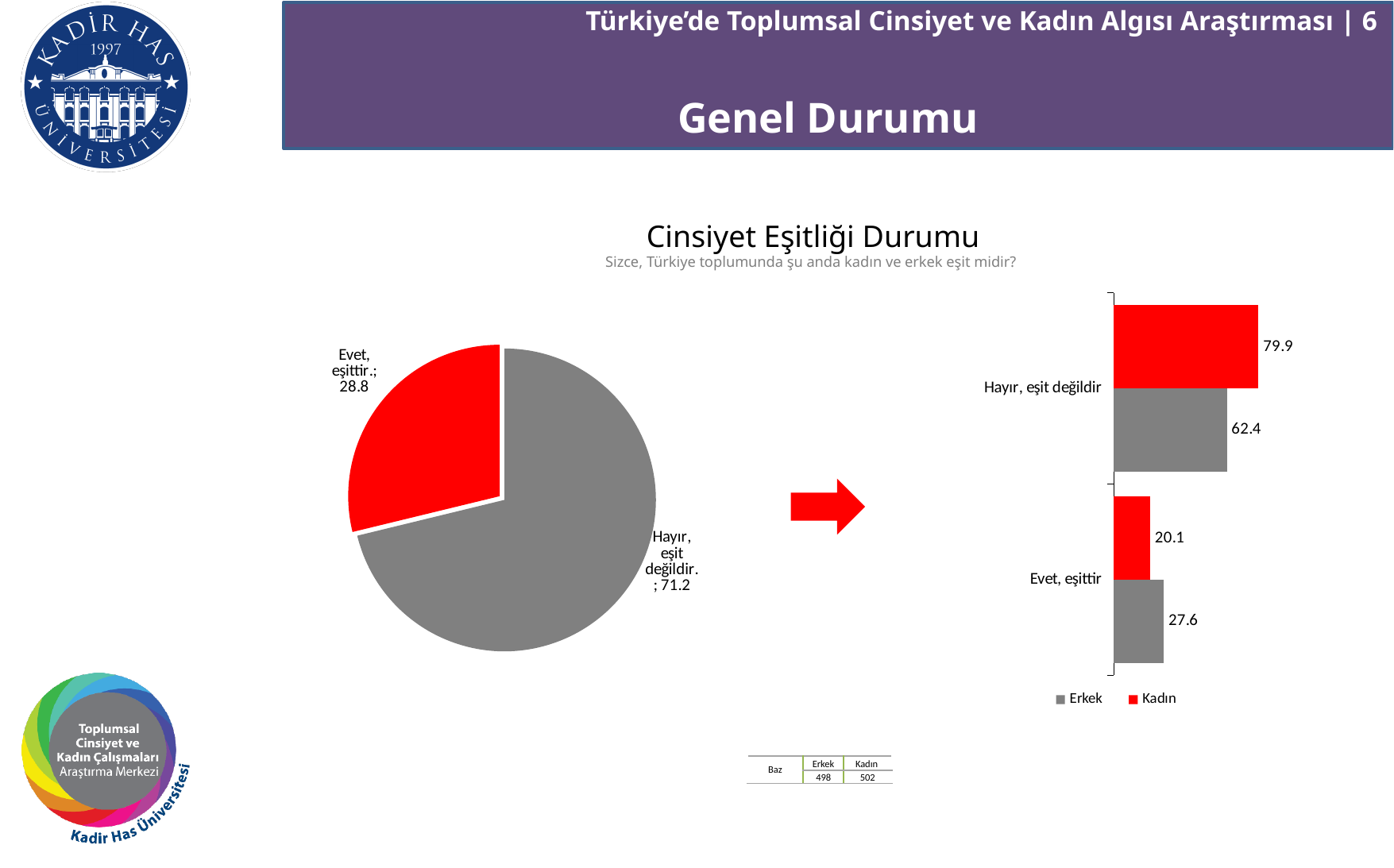
In the bar chart on the right, which bar has the lowest value? Kadın, Evet, eşittir (20.1) In the pie chart on the left, how many slices are there? 2 What kind of chart is the chart on the right? Bar chart In the bar chart on the right, what is the Kadın value for "Hayır, eşit değildir"? 79.9 In the pie chart on the left, which slice is the largest? Hayır, eşit değildir. In the bar chart on the right, which colour represents the Kadın series? Red In the bar chart on the right, what is the difference between the Kadın and Erkek values for "Hayır, eşit değildir"? 17.5 In the bar chart on the right, which is larger for "Evet, eşittir": the Erkek value or the Kadın value? Erkek In the bar chart on the right, how many series does the legend list? 2 In the pie chart on the left, what is the value for "Hayır, eşit değildir."? 71.2 In the bar chart on the right, what is the Erkek value for "Evet, eşittir"? 27.6 In the pie chart on the left, what is the value for "Evet, eşittir."? 28.8